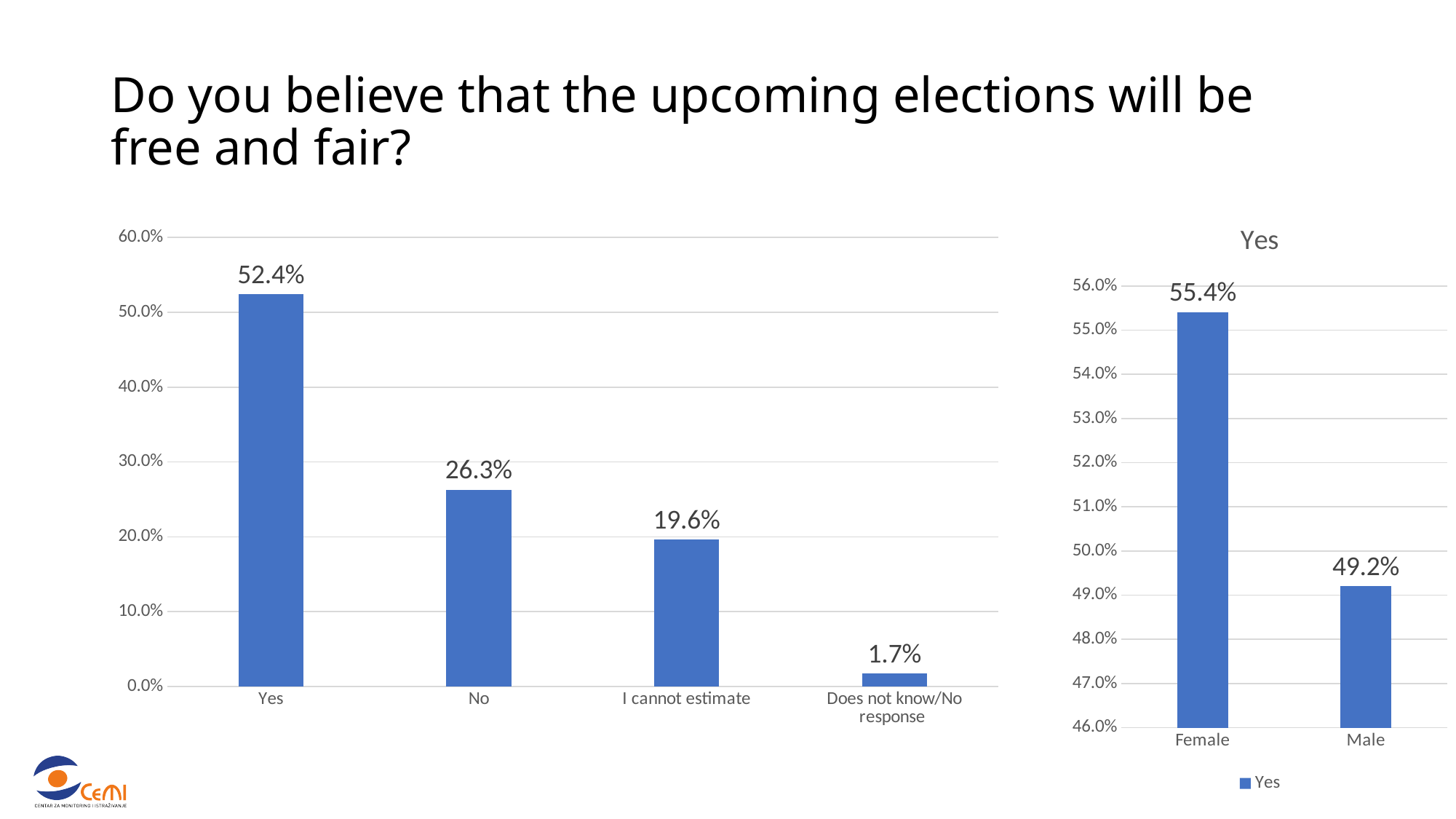
In the left chart, which response category has the lowest value? Does not know/No response In the left chart, what is the difference between the "Yes" and "No" values? 26.1% In the chart titled "Yes" on the right, what is the value for Female? 55.4% In the left chart, what percentage of respondents answered "No"? 26.3% In the left chart, what percentage of respondents answered "Yes"? 52.4% In the left chart, which response category has the highest value? Yes In the chart titled "Yes" on the right, which group has the larger value, Female or Male? Female In the left chart, what is the value for "I cannot estimate"? 19.6% What type of chart is the chart on the right? Bar chart In the left chart, how many response categories are shown? 4 In the chart titled "Yes" on the right, what is the value for Male? 49.2% In the chart titled "Yes" on the right, what is the difference between the Female and Male values? 6.2%